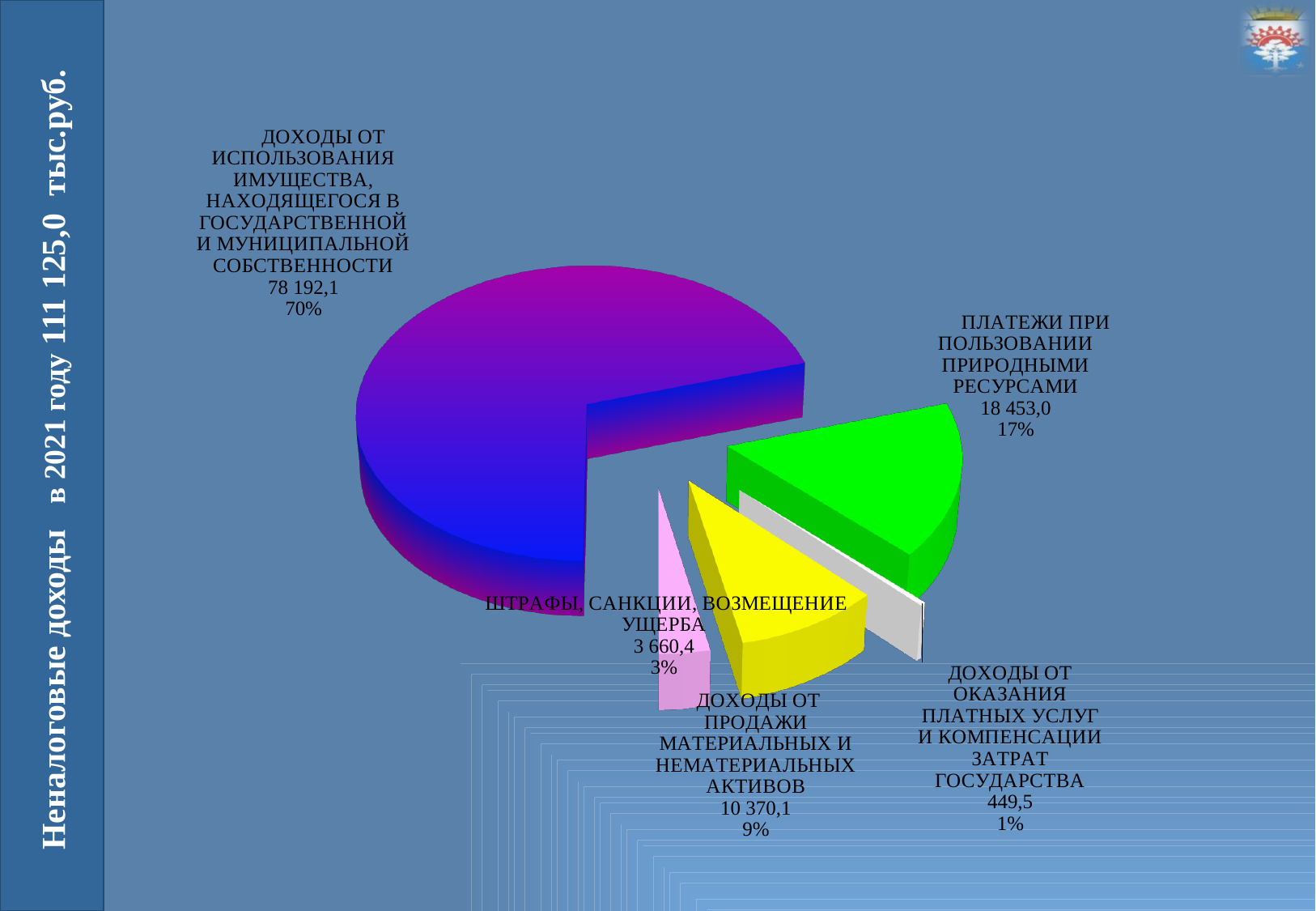
What share of the pie is «Доходы от использования имущества, находящегося в государственной и муниципальной собственности»? 70% Which is larger: «Платежи при пользовании природными ресурсами» or «Доходы от продажи материальных и нематериальных активов»? Платежи при пользовании природными ресурсами What is the difference between «Платежи при пользовании природными ресурсами» (18 453,0) and «Доходы от продажи материальных и нематериальных активов» (10 370,1)? 8 082,9 What is the value for «Доходы от продажи материальных и нематериальных активов»? 10 370,1 Which category has the smallest slice? Доходы от оказания платных услуг и компенсации затрат государства What is the value for «Штрафы, санкции, возмещение ущерба»? 3 660,4 What share of the pie is «Платежи при пользовании природными ресурсами»? 17% What is the value for «Платежи при пользовании природными ресурсами»? 18 453,0 What is the value for «Доходы от оказания платных услуг и компенсации затрат государства»? 449,5 What kind of chart is shown on the slide? pie chart Which category has the largest slice? Доходы от использования имущества, находящегося в государственной и муниципальной собственности How many slices does the pie chart have? 5